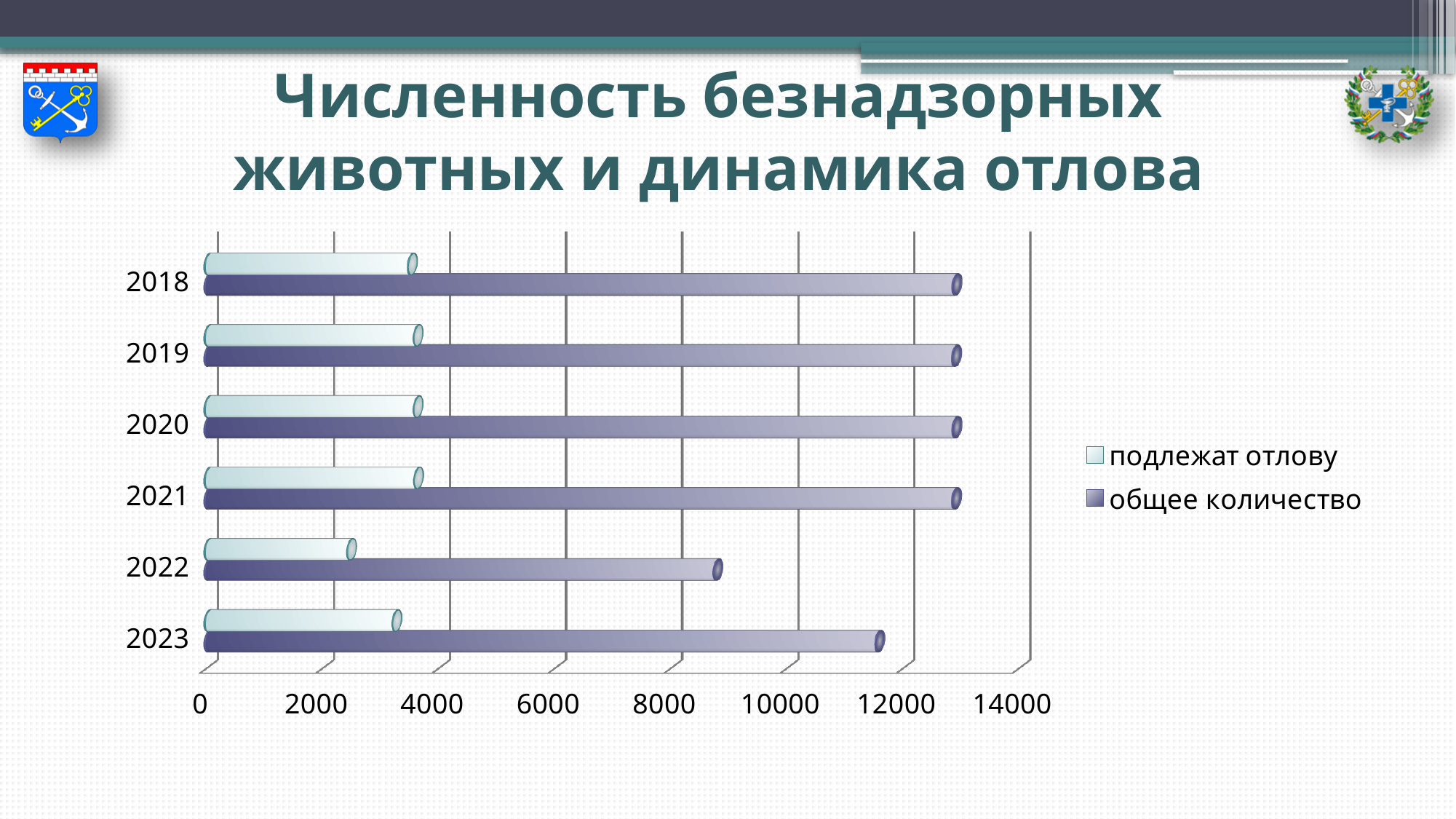
What is the title of the chart on the slide? Численность безнадзорных животных и динамика отлова How many years (categories) are shown on the chart? 6 Is the value for "общее количество" in 2018 greater or less than 12000? greater Is the value for "общее количество" in 2022 greater or less than 10000? less Which is larger: "общее количество" in 2023 or "общее количество" in 2022? 2023 Which year has the lowest value for "общее количество"? 2022 What kind of chart is shown on the slide? bar chart Which is larger in 2021: "подлежат отлову" or "общее количество"? общее количество Is the value for "подлежат отлову" in 2022 greater or less than 4000? less How many series does the legend list? 2 Which year has the lowest value for "подлежат отлову"? 2022